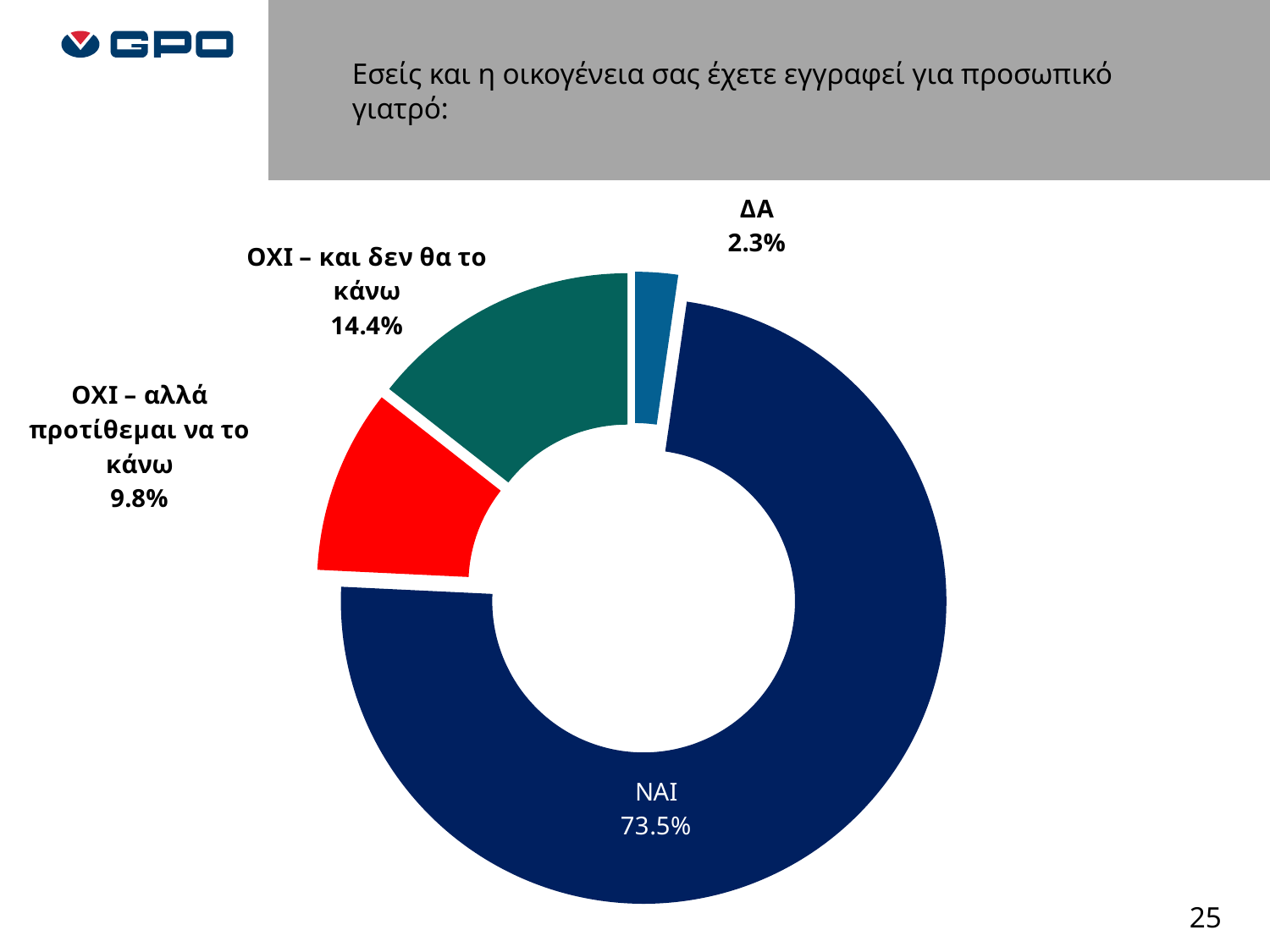
What percentage of respondents answered ΝΑΙ? 73.5% What kind of chart is shown on the slide? Pie chart (doughnut) How many categories are shown in the chart? 4 What is the difference in percentage points between ΟΧΙ – και δεν θα το κάνω and ΟΧΙ – αλλά προτίθεμαι να το κάνω? 4.6 Which category has the largest share of the chart? ΝΑΙ Which is larger: the share for ΟΧΙ – και δεν θα το κάνω or the share for ΟΧΙ – αλλά προτίθεμαι να το κάνω? ΟΧΙ – και δεν θα το κάνω What percentage is shown for ΔΑ? 2.3% What colour is the ΝΑΙ slice? Dark navy blue What is the value for the slice labelled ΟΧΙ – και δεν θα το κάνω? 14.4% What is the combined percentage of the two ΟΧΙ categories? 24.2% Which category has the smallest share of the chart? ΔΑ What is the value for ΟΧΙ – αλλά προτίθεμαι να το κάνω? 9.8%